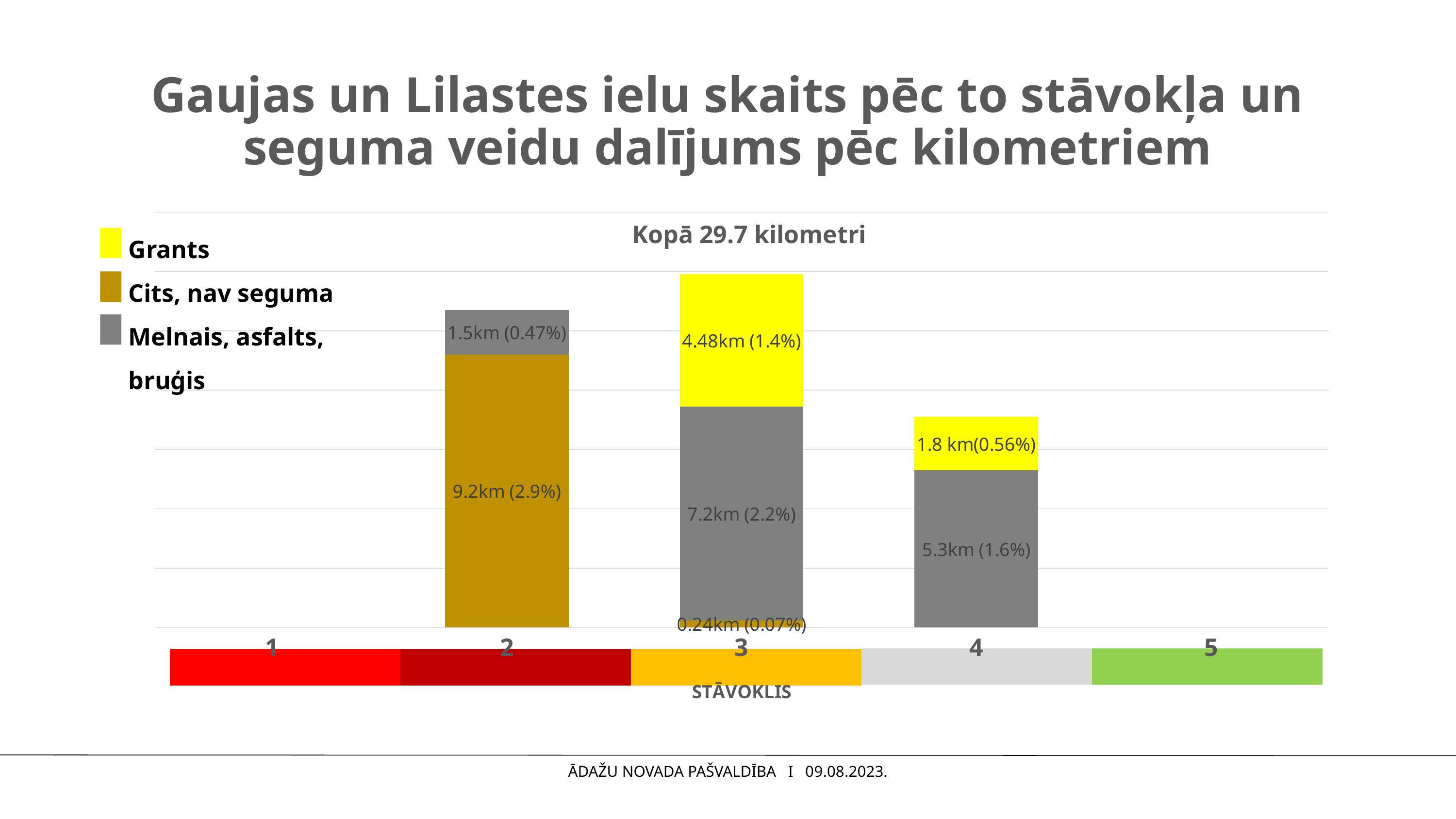
Which category has the tallest stacked bar? 3 What is the value of the Grants segment for category 3? 4.48km (1.4%) How many series does the legend list? 3 What is the value of the Melnais, asfalts, bruģis segment for category 2? 1.5km (0.47%) What is the value of the Melnais, asfalts, bruģis segment for category 4? 5.3km (1.6%) What is the value of the Cits, nav seguma segment for category 2? 9.2km (2.9%) What total length is stated above the chart? Kopā 29.7 kilometri How many categories are shown on the x axis? 5 What is the difference in kilometres between the Cits, nav seguma segment and the Melnais, asfalts, bruģis segment in category 2? 7.7 km What is the total length in kilometres of the stacked bar for category 2? 10.7 km Which is larger: the Melnais, asfalts, bruģis segment in category 3 or in category 4? Category 3 What is the value of the Grants segment for category 4? 1.8 km(0.56%)